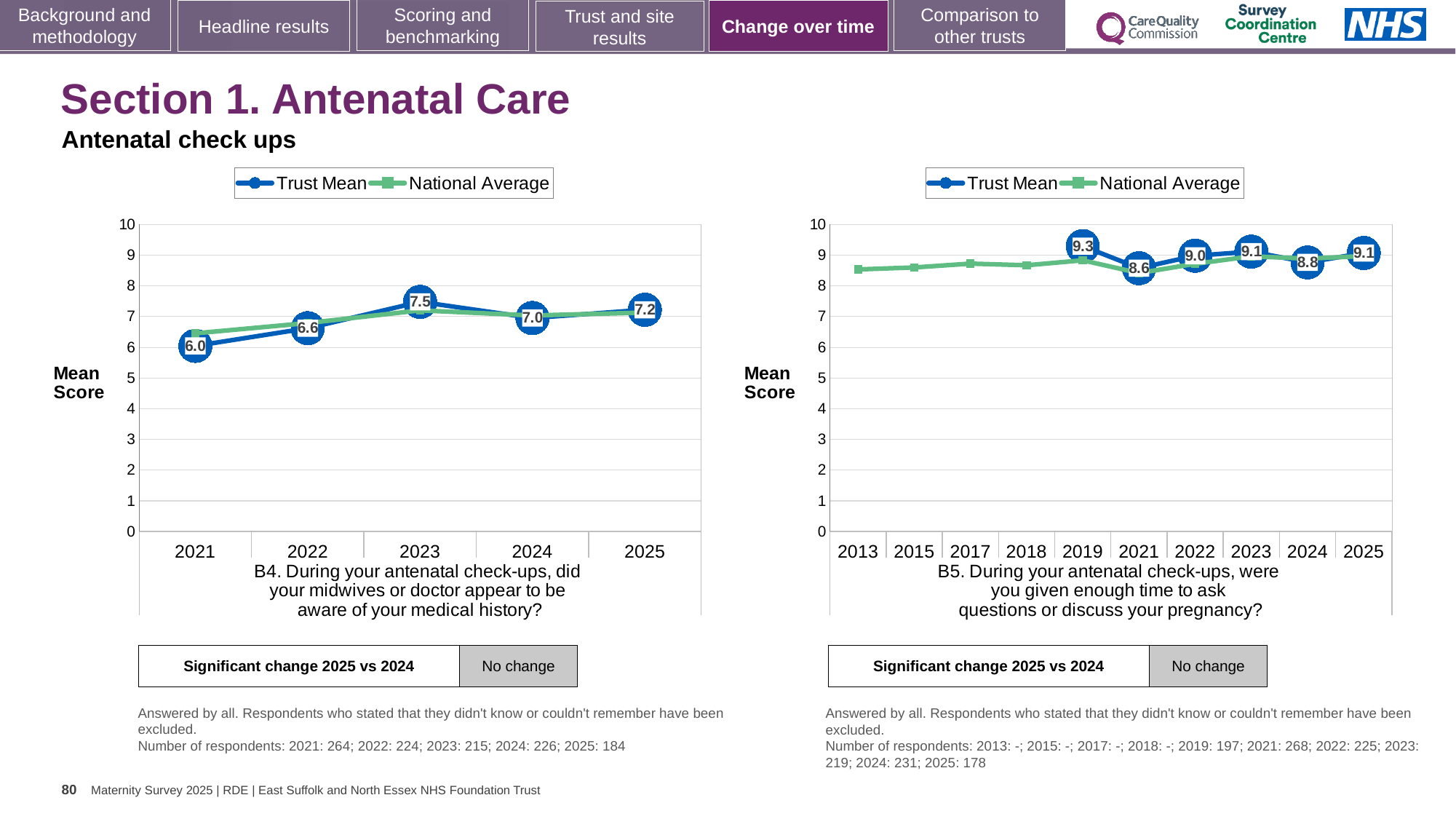
In the B4 chart (left), which year has the highest Trust Mean? 2023 In the B4 chart (left), what is the difference between the Trust Mean for 2023 and 2021? 1.5 In the B4 chart (left), which year has the lowest Trust Mean? 2021 In the B5 chart (right), which year has the lowest Trust Mean? 2021 In the B5 chart (right), is the National Average for 2013 greater or less than 9? less In the B4 chart (left), how many years are shown on the x axis? 5 How many series does the legend of the B5 chart (right) list? 2 In the B5 chart (right), what is the Trust Mean for 2024? 8.8 In the B4 chart (left), what is the Trust Mean for 2021? 6.0 In the B4 chart (left), what is the Trust Mean for 2023? 7.5 In the B5 chart (right), is the Trust Mean for 2022 or 2024 larger? 2022 In the B5 chart (right), what is the Trust Mean for 2019? 9.3